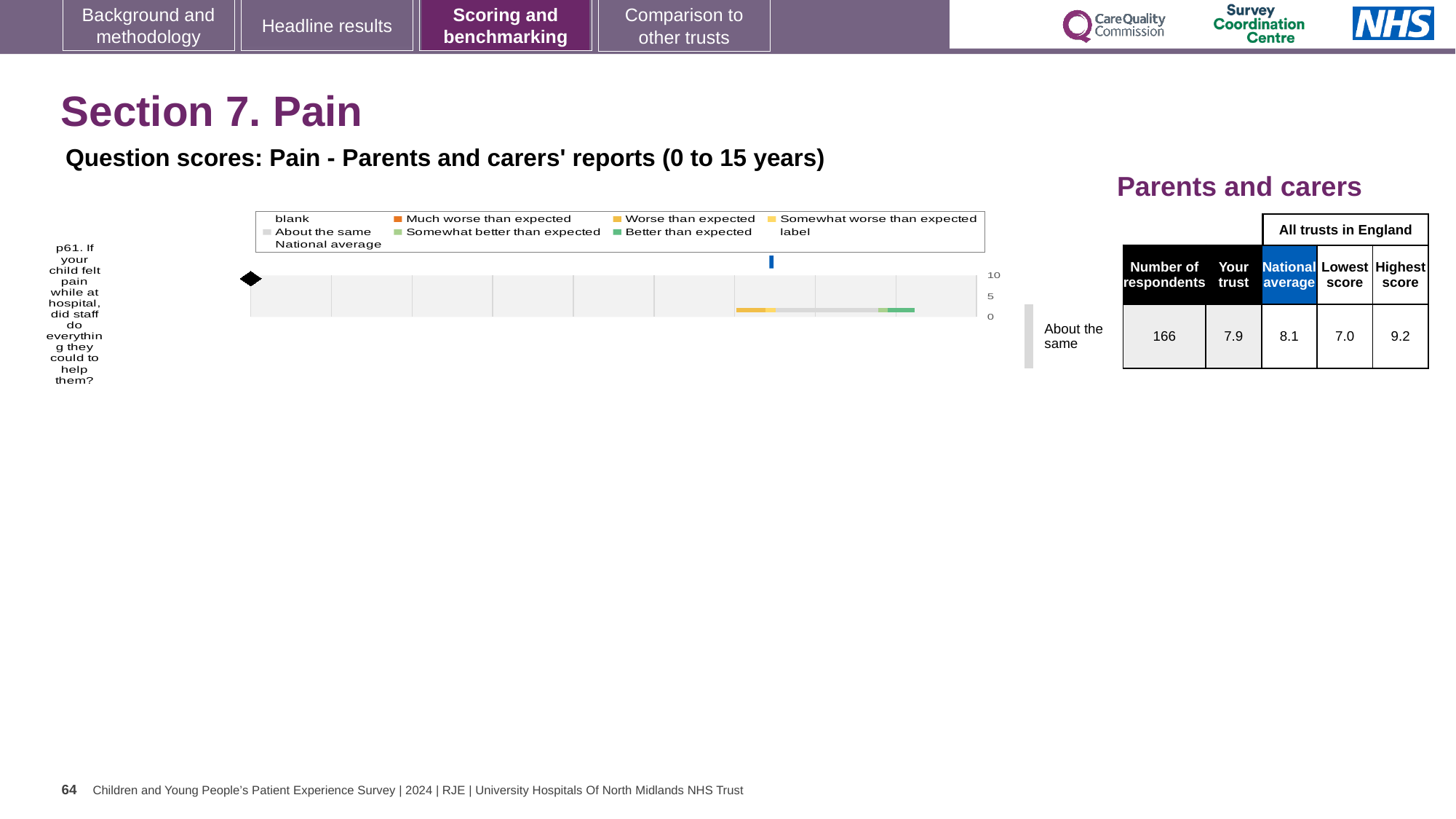
What is the difference between the highest score and the lowest score for question p61? 2.2 How many survey questions are plotted in the chart? 1 What kind of chart is shown on the slide for question p61? bar chart What is the 'Your trust' score for question p61? 7.9 In the chart legend, what colour represents 'Better than expected'? green In the chart legend, what colour represents 'Much worse than expected'? orange What is the highest score among all trusts in England for question p61? 9.2 Which is larger for question p61: the 'Your trust' score or the national average? National average What is the national average score for question p61? 8.1 Which benchmark category is question p61 assigned to? About the same What is the lowest score among all trusts in England for question p61? 7.0 How many respondents answered question p61? 166